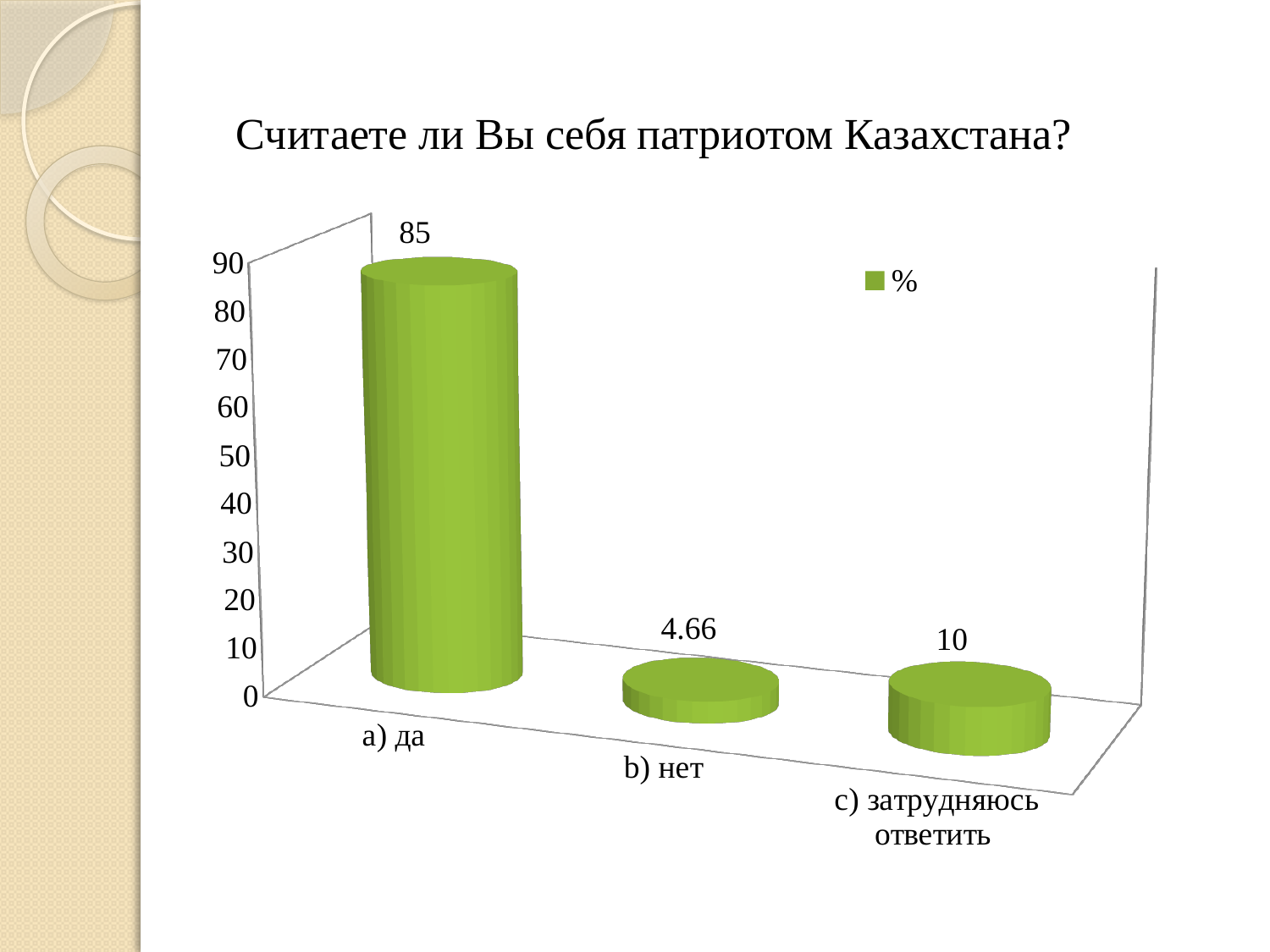
What kind of chart is shown on the slide? bar chart What is the value for "b) нет"? 4.66 What is the difference between the values for "a) да" and "c) затрудняюсь ответить"? 75 How many series does the legend list? 1 Which category has the highest value? a) да Which is larger, the value for "b) нет" or the value for "c) затрудняюсь ответить"? c) затрудняюсь ответить Which category has the lowest value? b) нет What is the title of the chart? Считаете ли Вы себя патриотом Казахстана? How many categories are shown on the chart? 3 What is the value for "a) да"? 85 What is the value for "c) затрудняюсь ответить"? 10 What is the difference between the values for "c) затрудняюсь ответить" and "b) нет"? 5.34